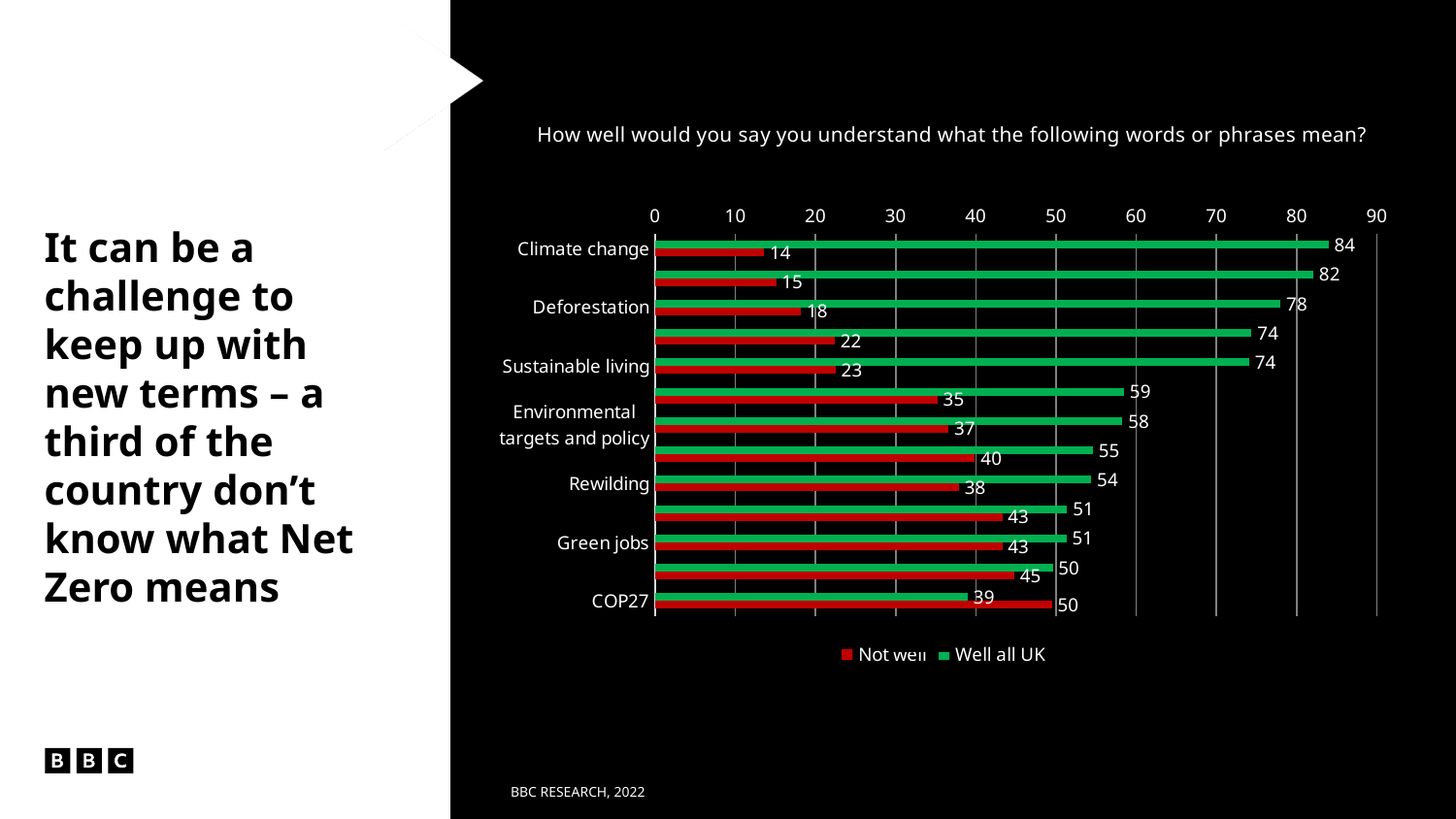
What is the difference between the "Well all UK" and "Not well" values for Climate change? 70 What is the "Not well" value for COP27? 50 What is the "Well all UK" value for Climate change? 84 For Green jobs, which is larger: the "Well all UK" value or the "Not well" value? Well all UK Which labelled category has the highest "Well all UK" value? Climate change Which labelled category has the lowest "Not well" value? Climate change What is the "Not well" value for Sustainable living? 23 How many series does the legend list? 2 What is the "Well all UK" value for Rewilding? 54 What is the "Not well" value for Climate change? 14 What is the "Well all UK" value for Deforestation? 78 What kind of chart is shown on the slide? Bar chart